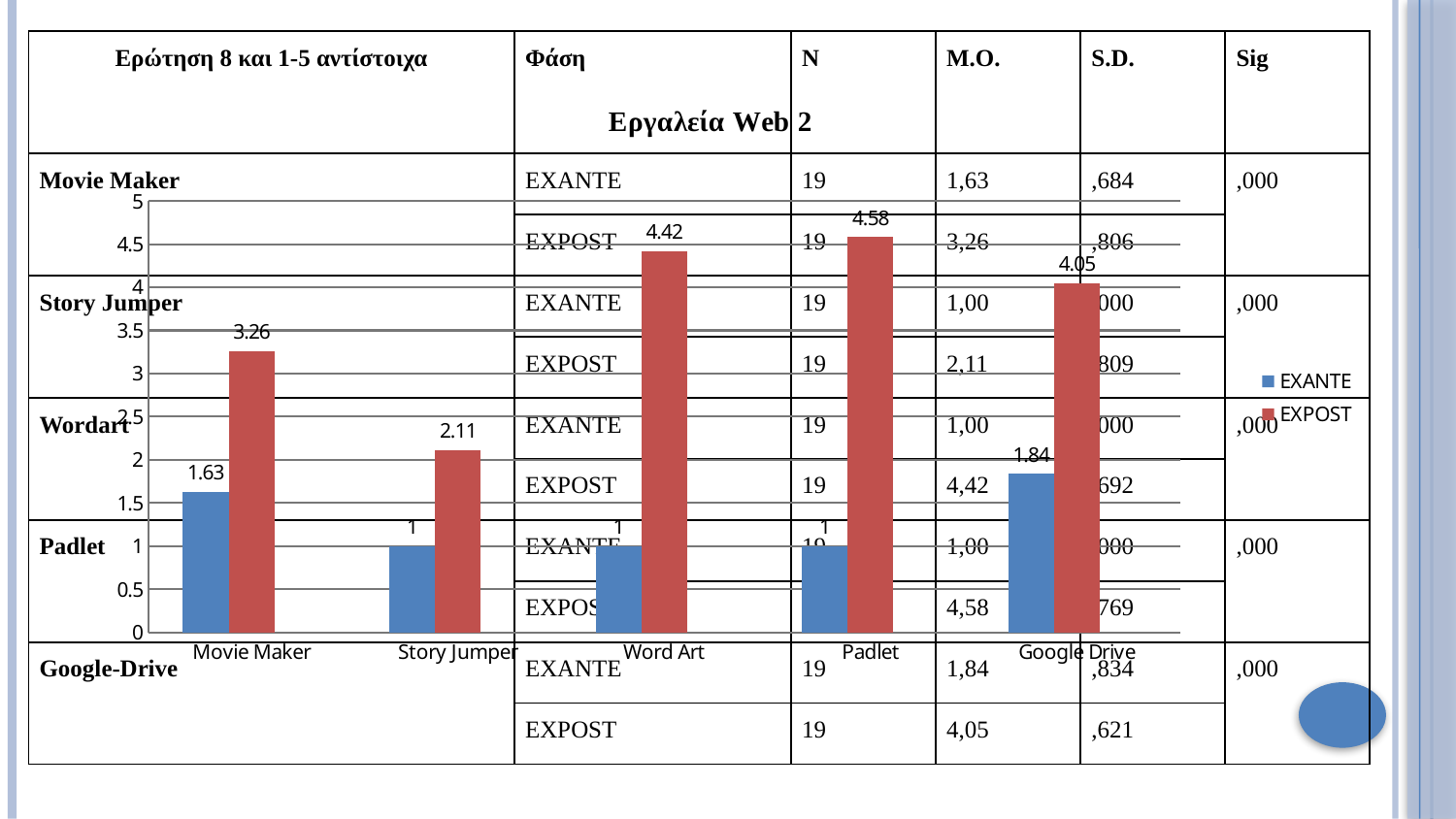
Which colour represents the EXPOST series in the chart? red What is the EXPOST value for Movie Maker? 3.26 How many categories are shown on the x axis of the chart? 5 What is the EXANTE value for Google Drive? 1.84 What is the difference between the EXPOST and EXANTE values for Movie Maker? 1.63 Is the EXPOST value for Padlet greater or less than 4? greater What kind of chart is shown on the slide? bar chart What is the EXPOST value for Word Art? 4.42 Which category has the highest EXPOST value? Padlet Which category has the lowest EXPOST value? Story Jumper Which is larger, the EXPOST value for Google Drive or the EXPOST value for Word Art? Word Art How many series does the chart legend list? 2